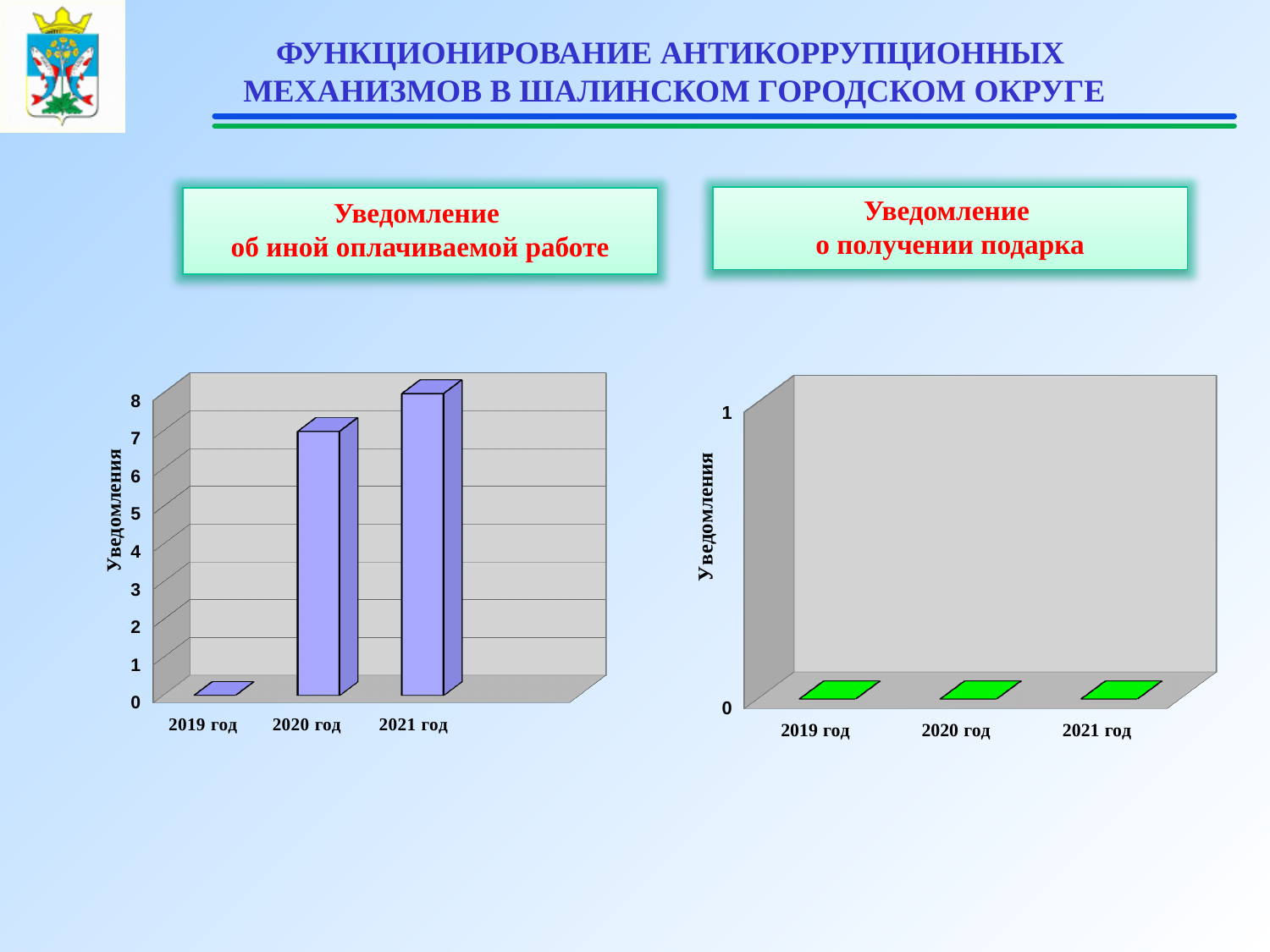
In the chart titled "Уведомление об иной оплачиваемой работе", how many years are shown on the x axis? 3 In the chart titled "Уведомление об иной оплачиваемой работе", which is larger, the value for 2020 год or 2019 год? 2020 год In the chart titled "Уведомление об иной оплачиваемой работе", what is the value for 2019 год? 0 What is the y-axis label of the chart titled "Уведомление о получении подарка"? Уведомления In the chart titled "Уведомление об иной оплачиваемой работе", which year has the highest value? 2021 год What kind of chart is the chart titled "Уведомление об иной оплачиваемой работе"? bar chart In the chart titled "Уведомление об иной оплачиваемой работе", is the value for 2020 год greater or less than 5? greater In the chart titled "Уведомление о получении подарка", what is the value for 2020 год? 0 In the chart titled "Уведомление об иной оплачиваемой работе", do the values rise or fall from 2019 год to 2021 год? rise In the chart titled "Уведомление о получении подарка", how many years are shown on the x axis? 3 In the chart titled "Уведомление об иной оплачиваемой работе", which year has the lowest value? 2019 год In the chart titled "Уведомление об иной оплачиваемой работе", is the value for 2021 год greater or less than 6? greater